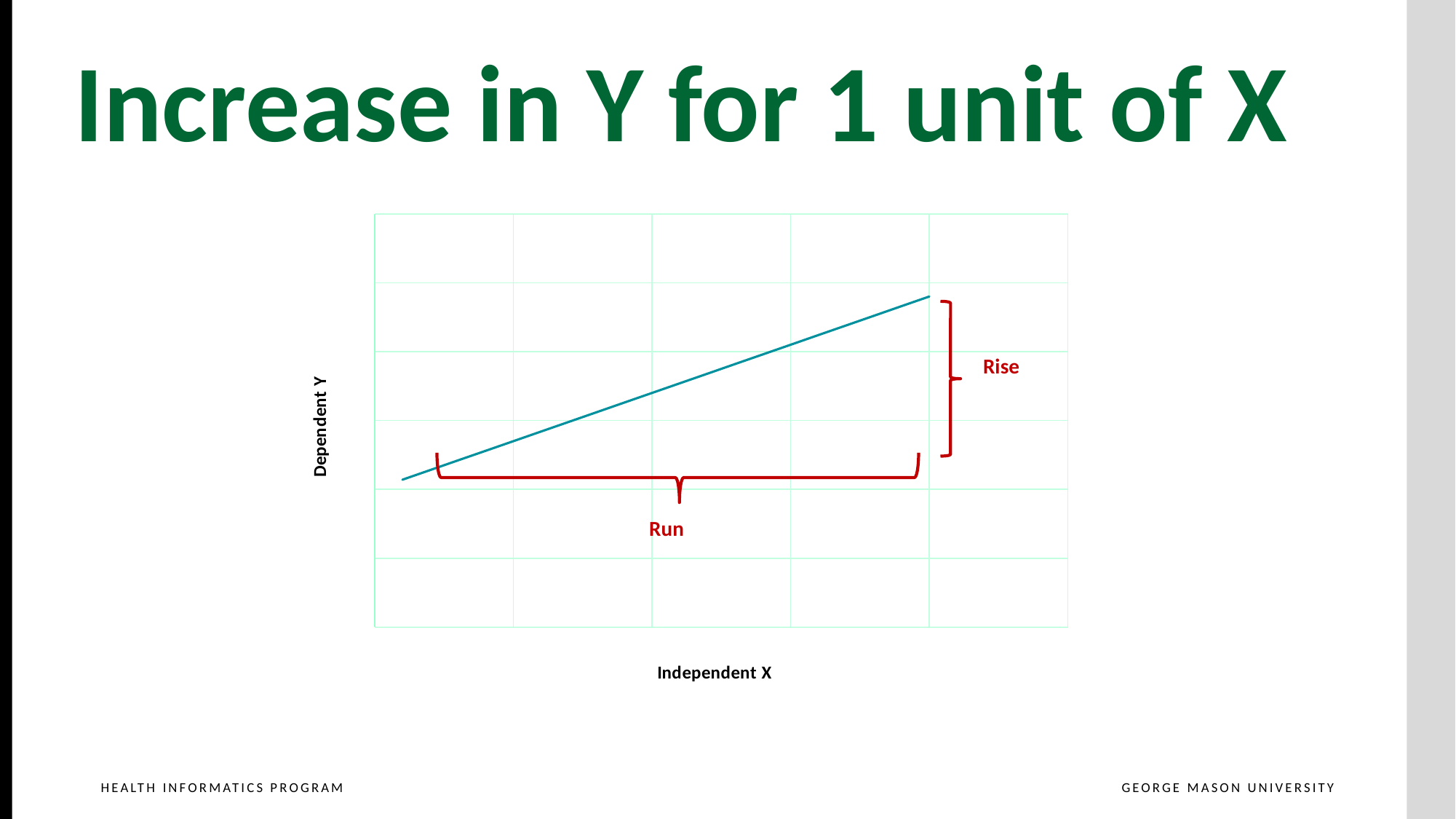
Do the values of the plotted line rise or fall as Independent X increases? Rise What is the label on the vertical axis of the chart? Dependent Y What is the label on the horizontal axis of the chart? Independent X What kind of chart is shown on the slide? Line chart